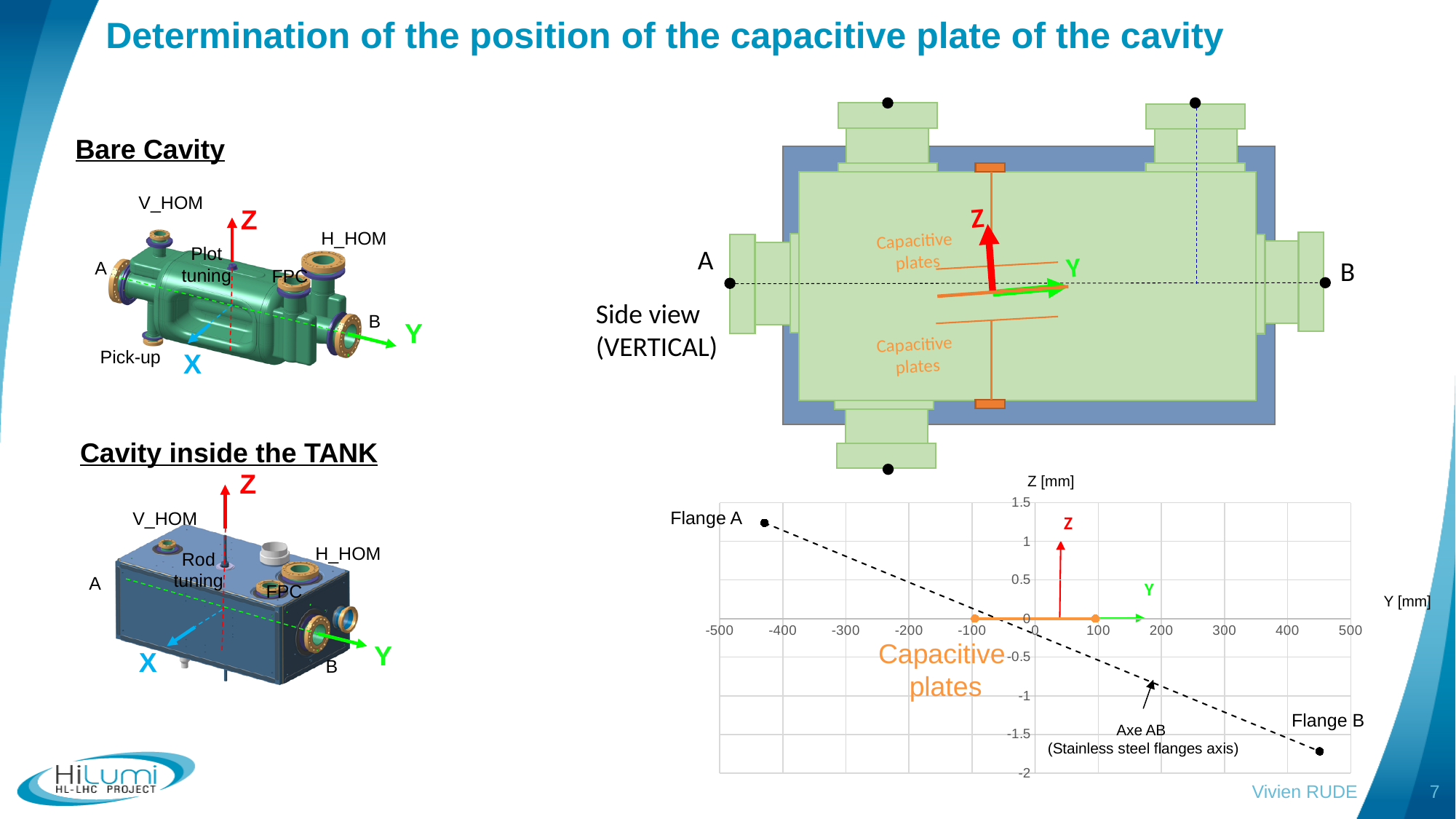
In the bottom-right chart, does Z rise or fall along the Axe AB line as Y increases from Flange A to Flange B? fall What is the lowest tick value shown on the Z axis of the bottom-right chart? -2 In the bottom-right chart, which flange has the higher Z value, Flange A or Flange B? Flange A What does the dashed line in the bottom-right chart represent? Axe AB (Stainless steel flanges axis) In the bottom-right chart, is the Y value of Flange A greater or less than -300? less What is the label of the horizontal axis of the chart at the bottom right? Y [mm] In the bottom-right chart, at what Z value is the capacitive plates segment drawn? 0 In the bottom-right chart, is the Y value of Flange B greater or less than 400? greater In the bottom-right chart, is the Z value of Flange B greater or less than -1.5? less What is the label of the vertical axis of the chart at the bottom right? Z [mm]